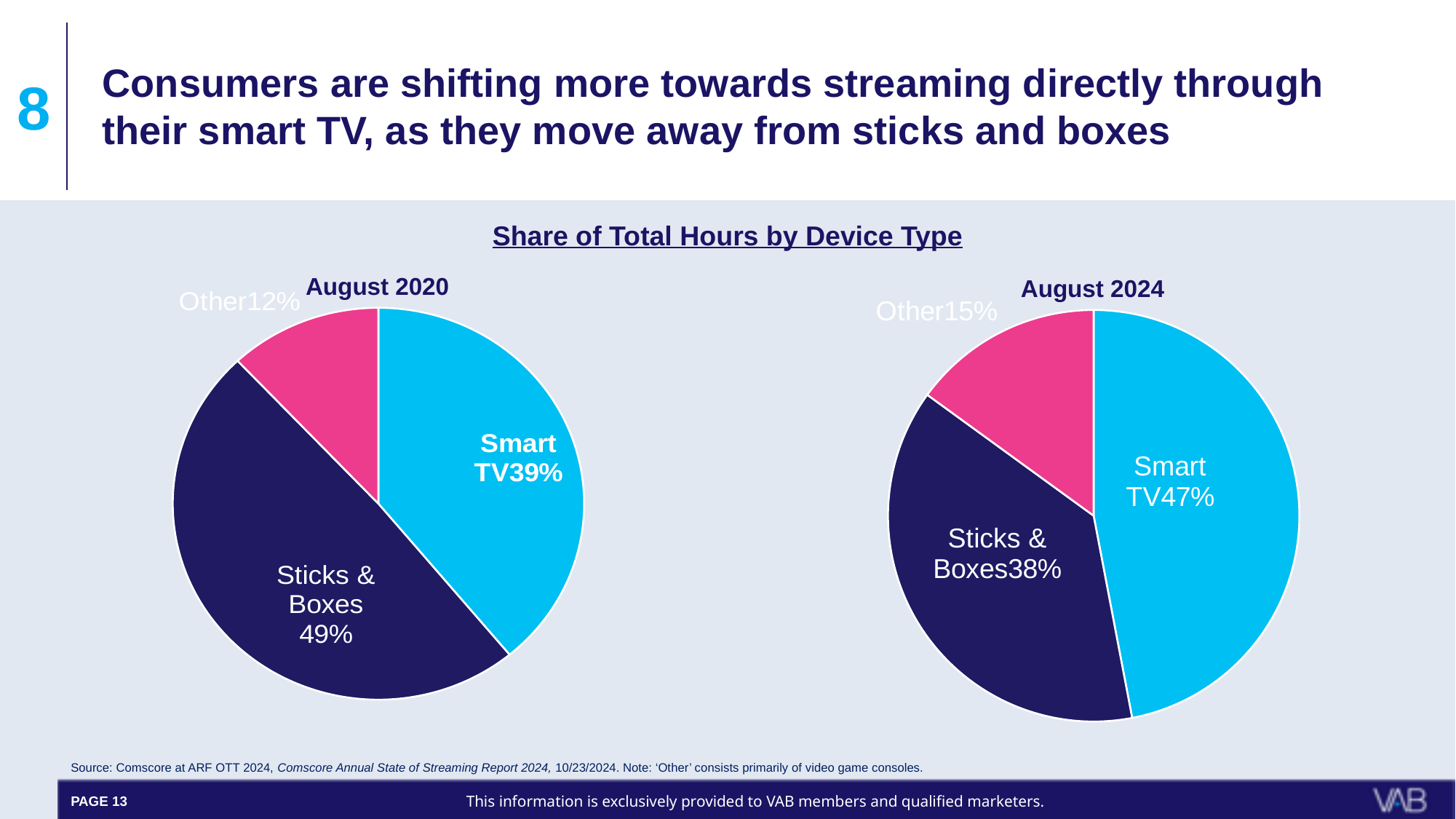
In the August 2020 pie chart, which is larger: the Smart TV share or the Sticks & Boxes share? Sticks & Boxes What type of chart is used to show the share of total hours by device type? Pie chart In the August 2024 pie chart, which device type has the smallest share? Other How many slices does the August 2024 pie chart have? 3 In the August 2020 pie chart, what is the difference between the Sticks & Boxes share and the Other share? 37 percentage points In the August 2020 pie chart, what share of total hours is Smart TV? 39% In the August 2024 pie chart, what share of total hours is Sticks & Boxes? 38% In the August 2024 pie chart, what share of total hours is Smart TV? 47% How much larger is the Smart TV share in the August 2024 pie chart than in the August 2020 pie chart? 8 percentage points In the August 2020 pie chart, which device type has the largest share? Sticks & Boxes In the August 2024 pie chart, which device type has the largest share? Smart TV In the August 2020 pie chart, what share of total hours is Other? 12%